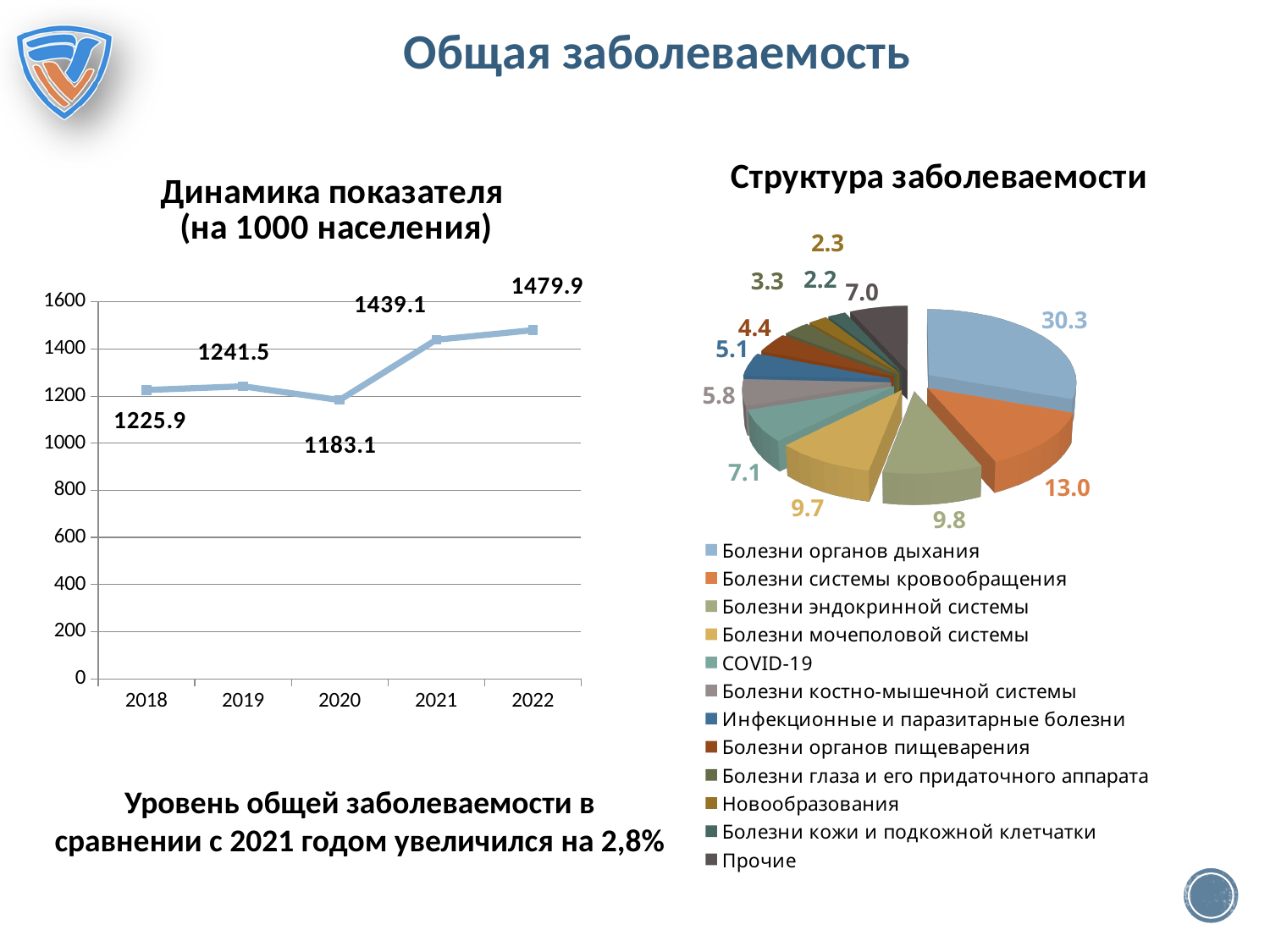
What kind of chart is 'Динамика показателя (на 1000 населения)'? line chart In the line chart 'Динамика показателя (на 1000 населения)', which year has the lowest value? 2020 In the pie chart 'Структура заболеваемости', which is larger: 'Болезни эндокринной системы' or 'COVID-19'? Болезни эндокринной системы In the line chart 'Динамика показателя (на 1000 населения)', what is the value for 2022? 1479.9 In the line chart 'Динамика показателя (на 1000 населения)', what is the difference between the 2021 and 2020 values? 256 In the pie chart 'Структура заболеваемости', which category has the largest slice? Болезни органов дыхания In the line chart 'Динамика показателя (на 1000 населения)', how many years are plotted? 5 How many categories does the legend of the pie chart 'Структура заболеваемости' list? 12 In the line chart 'Динамика показателя (на 1000 населения)', which year has the highest value? 2022 In the line chart 'Динамика показателя (на 1000 населения)', what is the value for 2020? 1183.1 In the line chart 'Динамика показателя (на 1000 населения)', does the value rise or fall from 2019 to 2020? fall In the pie chart 'Структура заболеваемости', what is the value for 'Болезни органов дыхания'? 30.3